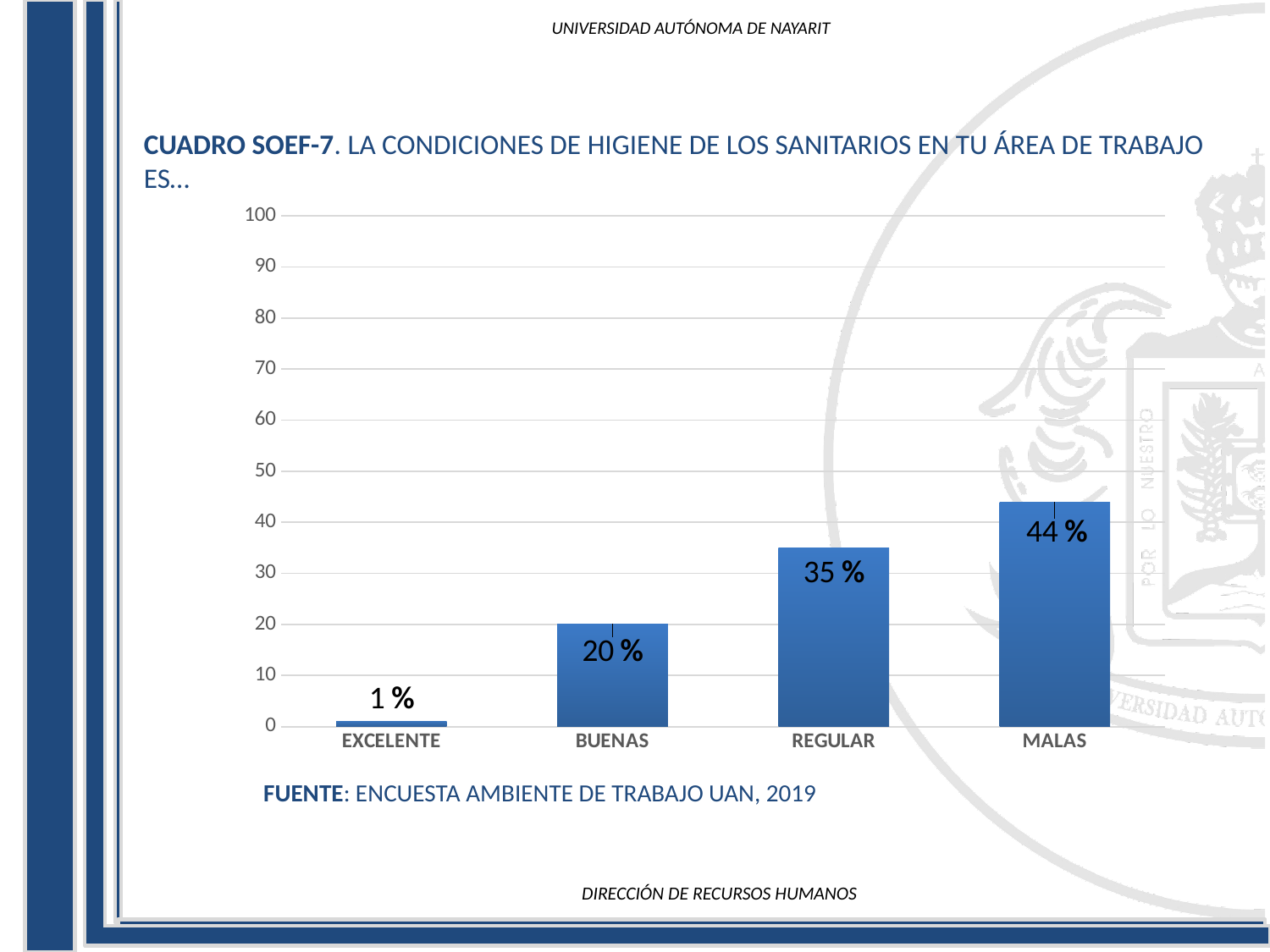
What source is cited below the chart? ENCUESTA AMBIENTE DE TRABAJO UAN, 2019 What is the value for BUENAS? 20 % How many categories are shown on the x axis? 4 Which category has the highest value? MALAS Which is larger, the value for BUENAS or the value for REGULAR? REGULAR Is the value for REGULAR greater or less than 30? greater What is the value for EXCELENTE? 1 % What kind of chart is shown on the slide? bar chart What is the value for MALAS? 44 % What is the difference between the values for MALAS and REGULAR? 9 % Which category has the lowest value? EXCELENTE Do the values rise or fall from EXCELENTE to MALAS along the x axis? rise